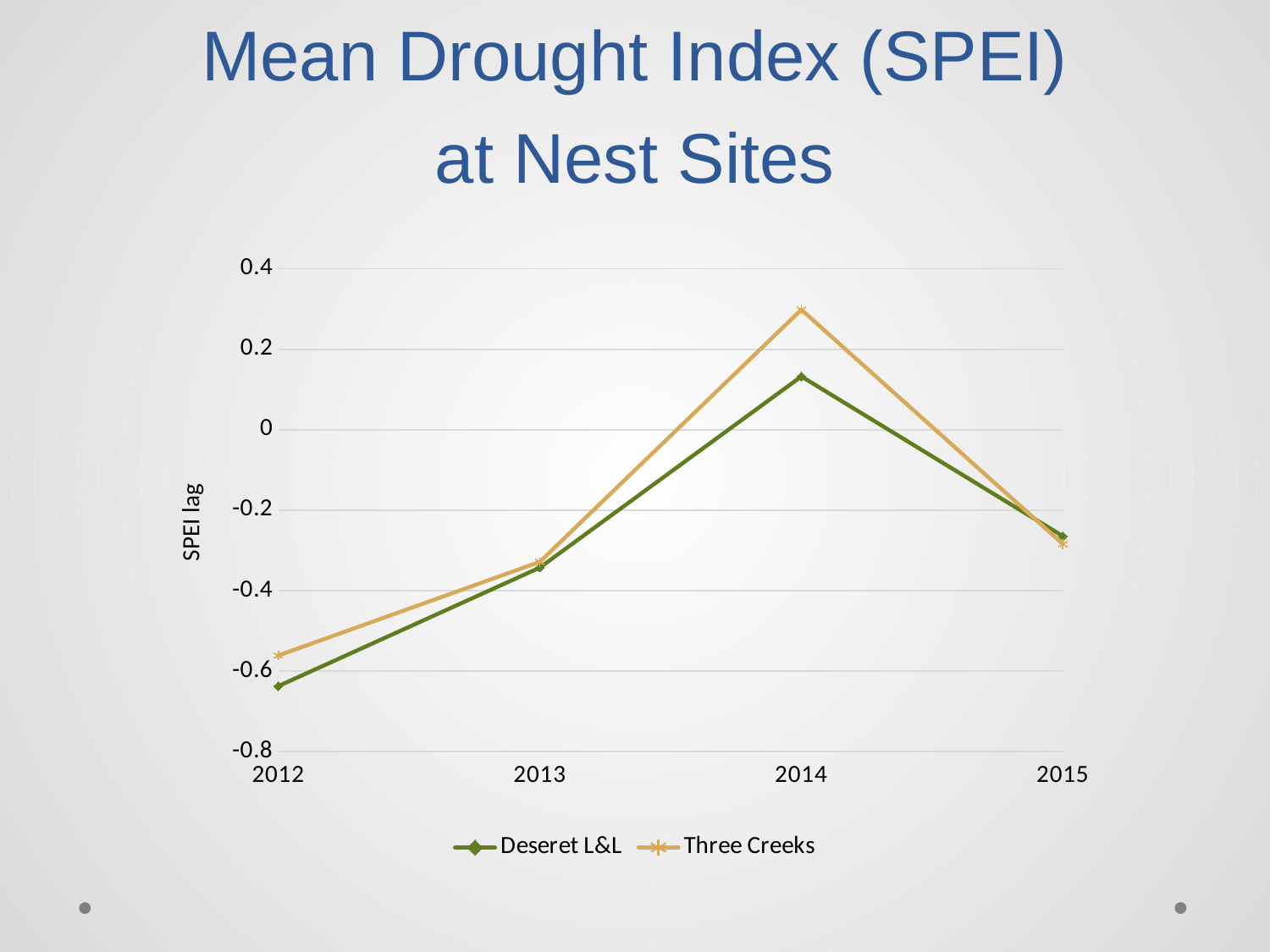
In 2014, which series has the higher value, Deseret L&L or Three Creeks? Three Creeks In which year does the Deseret L&L series reach its lowest value? 2012 How many series does the legend list? 2 Do the values for Deseret L&L rise or fall from 2012 to 2014? rise What is the label on the y axis? SPEI lag Is the value for Deseret L&L in 2012 greater or less than -0.6? less How many years are plotted along the x axis? 4 In 2012, which series has the lower value, Deseret L&L or Three Creeks? Deseret L&L In which year does the Three Creeks series reach its highest value? 2014 What kind of chart is shown on the slide? line chart Is the value for Three Creeks in 2014 greater or less than 0.2? greater Is the value for Deseret L&L in 2014 greater or less than 0? greater